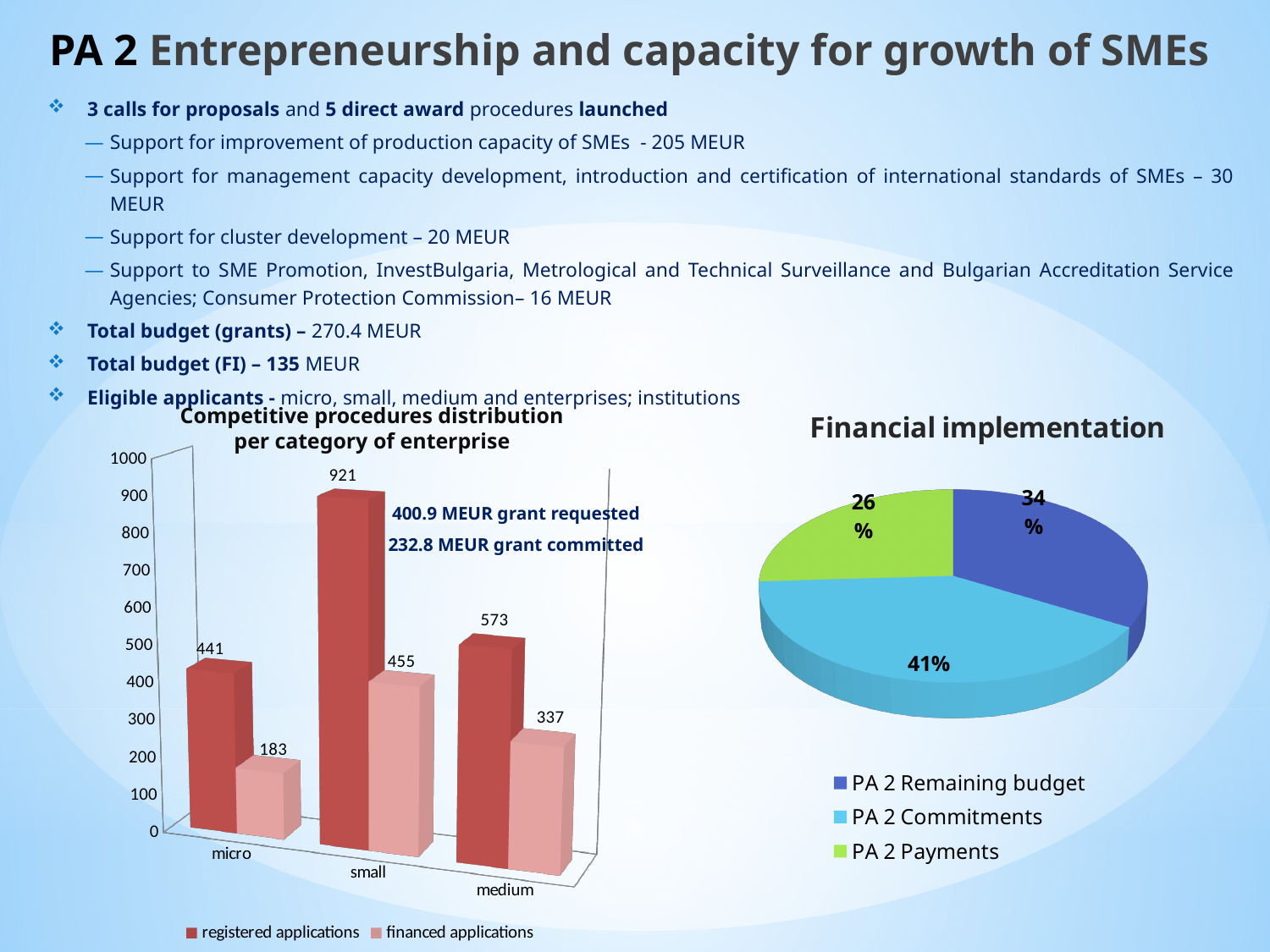
In the 'Competitive procedures distribution per category of enterprise' chart, how many series does the legend list? 2 In the 'Competitive procedures distribution per category of enterprise' chart, which is larger: financed applications for small enterprises or registered applications for micro enterprises? financed applications for small enterprises In the 'Competitive procedures distribution per category of enterprise' chart, which category has the highest number of registered applications? small In the 'Competitive procedures distribution per category of enterprise' chart, how many registered applications are shown for small enterprises? 921 In the 'Competitive procedures distribution per category of enterprise' chart, which category has the lowest number of financed applications? micro In the 'Financial implementation' chart, what share is shown for PA 2 Commitments? 41% In the 'Competitive procedures distribution per category of enterprise' chart, how many financed applications are shown for micro enterprises? 183 What kind of chart is the 'Financial implementation' chart? pie chart What kind of chart is the 'Competitive procedures distribution per category of enterprise' chart? bar chart In the 'Competitive procedures distribution per category of enterprise' chart, what is the difference between registered and financed applications for medium enterprises? 236 In the 'Financial implementation' chart, which category has the smallest slice? PA 2 Payments In the 'Competitive procedures distribution per category of enterprise' chart, how many enterprise categories are shown on the x axis? 3